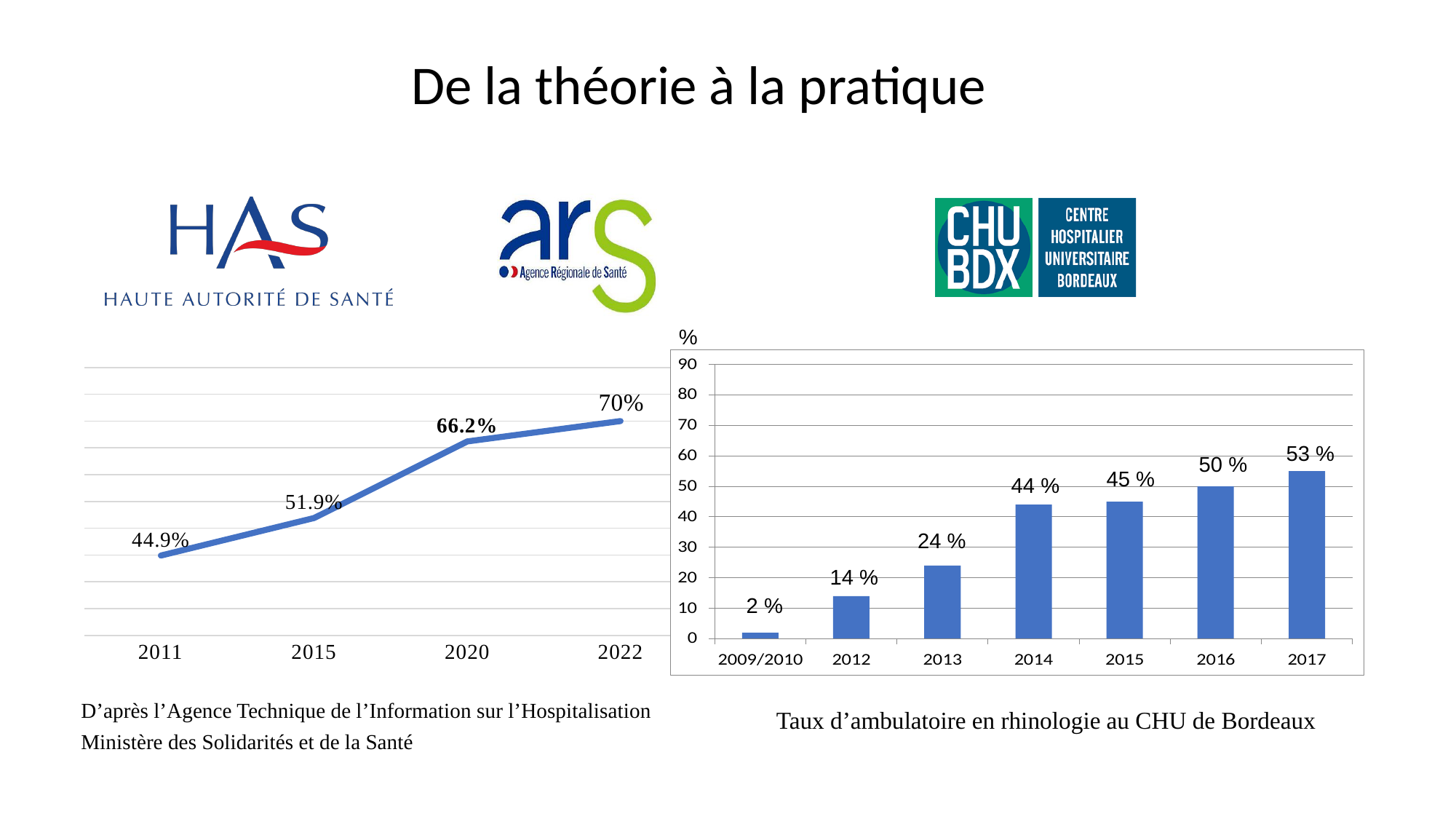
In the chart 'Taux d'ambulatoire en rhinologie au CHU de Bordeaux', which is larger, the value for 2014 or the value for 2016? 2016 In the line chart on the left of the slide, what is the value for 2011? 44.9% What kind of chart is 'Taux d'ambulatoire en rhinologie au CHU de Bordeaux'? bar chart In the chart 'Taux d'ambulatoire en rhinologie au CHU de Bordeaux', what is the difference between the values for 2017 and 2012? 39 % In the chart 'Taux d'ambulatoire en rhinologie au CHU de Bordeaux', how many categories are shown on the x axis? 7 In the line chart on the left of the slide, what is the value for 2020? 66.2% In the line chart on the left of the slide, which year has the highest value? 2022 In the chart 'Taux d'ambulatoire en rhinologie au CHU de Bordeaux', which category has the lowest value? 2009/2010 In the line chart on the left of the slide, how many data points are plotted? 4 In the line chart on the left of the slide, do the values rise or fall from 2011 to 2022? rise In the line chart on the left of the slide, what is the difference between the values for 2022 and 2011? 25.1% In the chart 'Taux d'ambulatoire en rhinologie au CHU de Bordeaux', what is the value for 2013? 24 %